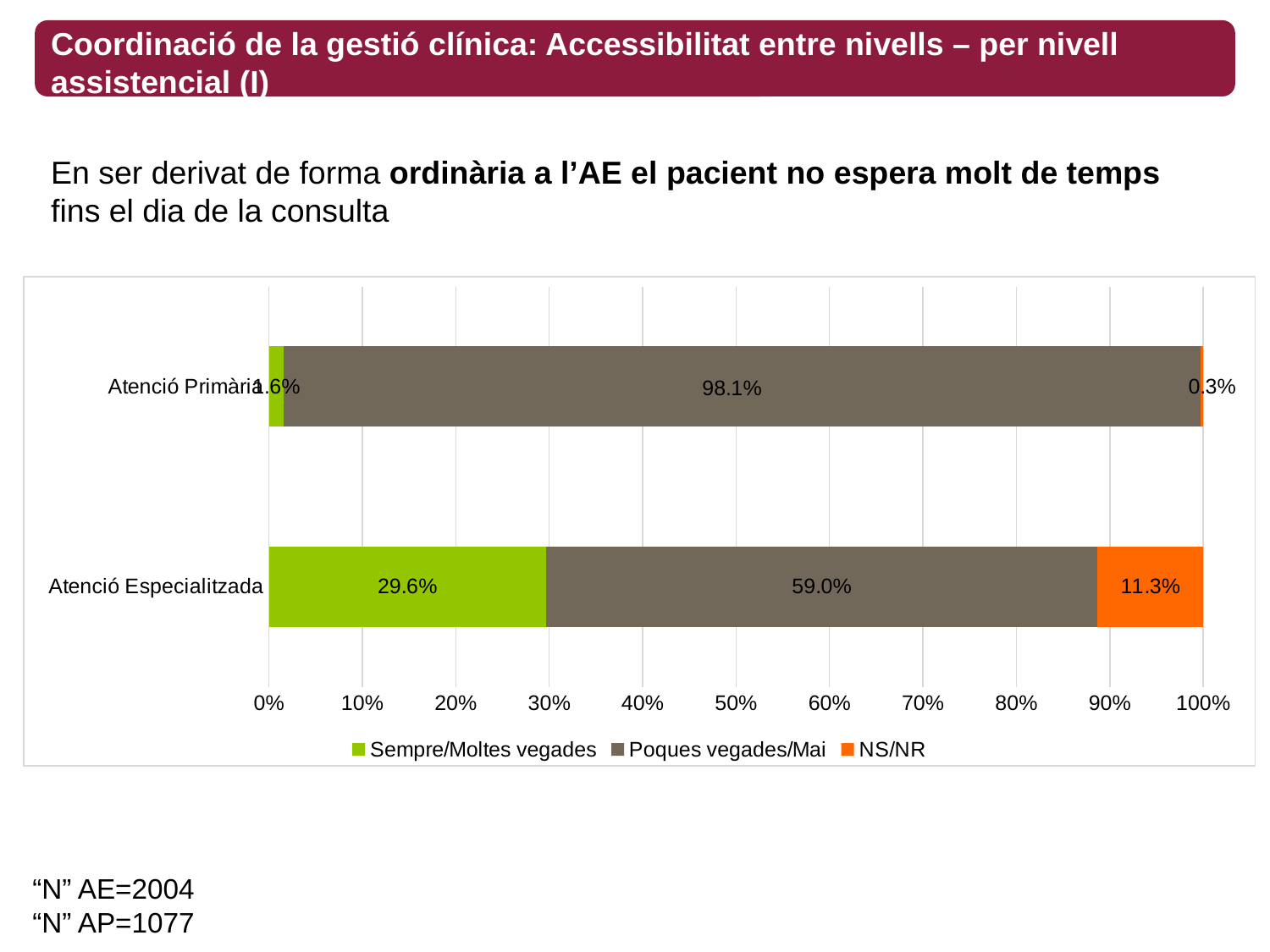
What is the value of Poques vegades/Mai for Atenció Primària? 98.1% Is the Poques vegades/Mai value for Atenció Especialitzada larger or smaller than the Sempre/Moltes vegades value for the same category? Larger How many categories are plotted on the chart? 2 What is the value of NS/NR for Atenció Primària? 0.3% What is the value of Sempre/Moltes vegades for Atenció Especialitzada? 29.6% How many series does the legend list? 3 What is the value of Poques vegades/Mai for Atenció Especialitzada? 59.0% What is the value of NS/NR for Atenció Especialitzada? 11.3% Which colour represents the NS/NR series in the chart? Orange What kind of chart is shown on the slide? Stacked bar chart What is the difference between the Poques vegades/Mai values for Atenció Primària and Atenció Especialitzada? 39.1% Which category has the higher value for Sempre/Moltes vegades? Atenció Especialitzada